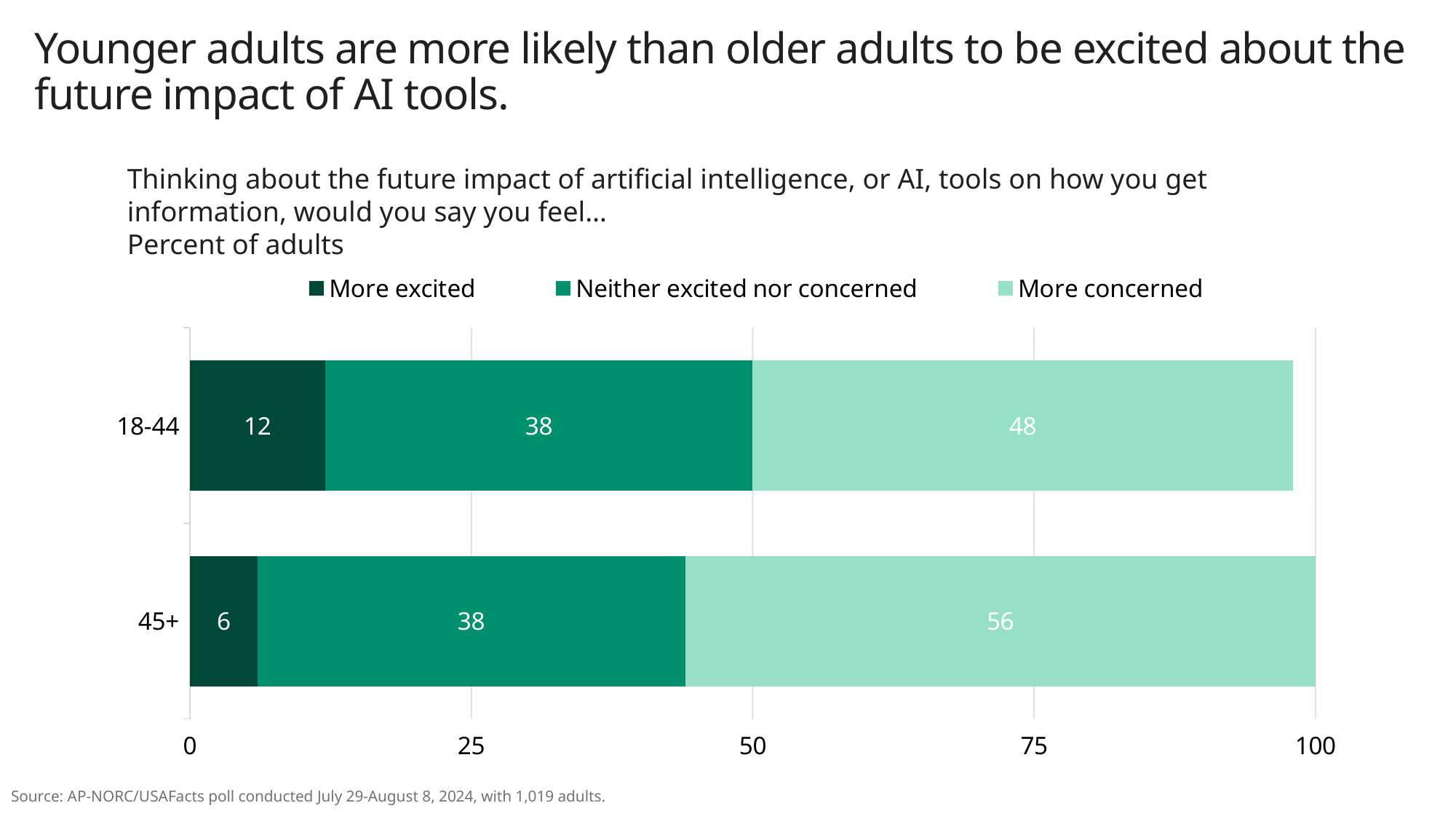
Which age group has the higher share of adults who are more concerned about AI tools? 45+ Which age group has the higher share of adults who are more excited about AI tools? 18-44 What percent of adults aged 45+ say they are neither excited nor concerned? 38 What percent of adults aged 45+ say they are more concerned about the future impact of AI tools? 56 What is the difference in the 'More concerned' percentage between the 45+ group and the 18-44 group? 8 What kind of chart is shown on the slide? Stacked bar chart What percent of adults aged 18-44 say they are more excited about the future impact of AI tools? 12 What is the total of the stacked bar for the 45+ age group? 100 What is the difference in the 'More excited' percentage between the 18-44 group and the 45+ group? 6 What percent of adults aged 18-44 say they are more concerned? 48 How many series does the legend list? 3 How many age groups are shown in the chart? 2